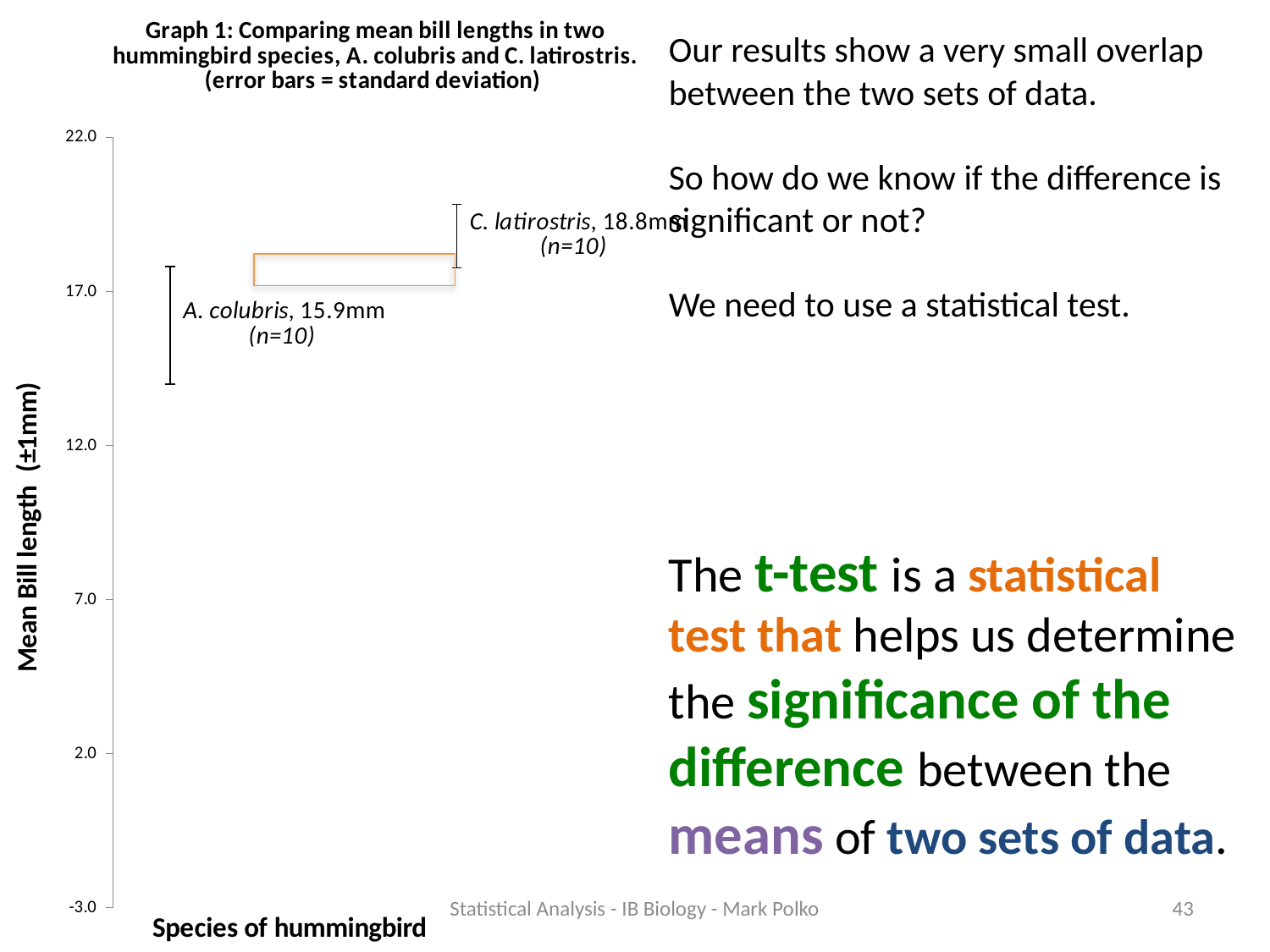
How many hummingbird species are compared in the chart? 2 What do the error bars in the chart represent? standard deviation Which species has the lower mean bill length? A. colubris What is the mean bill length for A. colubris? 15.9mm Is the mean bill length for A. colubris greater or less than 17.0? less What is the mean bill length for C. latirostris? 18.8mm What is the label of the y-axis? Mean Bill length (±1mm) Is the mean bill length for C. latirostris greater or less than 17.0? greater What is the difference between the mean bill lengths of C. latirostris and A. colubris? 2.9mm What is the sample size (n) for each species shown in the chart? 10 Which species has the higher mean bill length? C. latirostris Is the mean bill length of A. colubris larger or smaller than that of C. latirostris? smaller